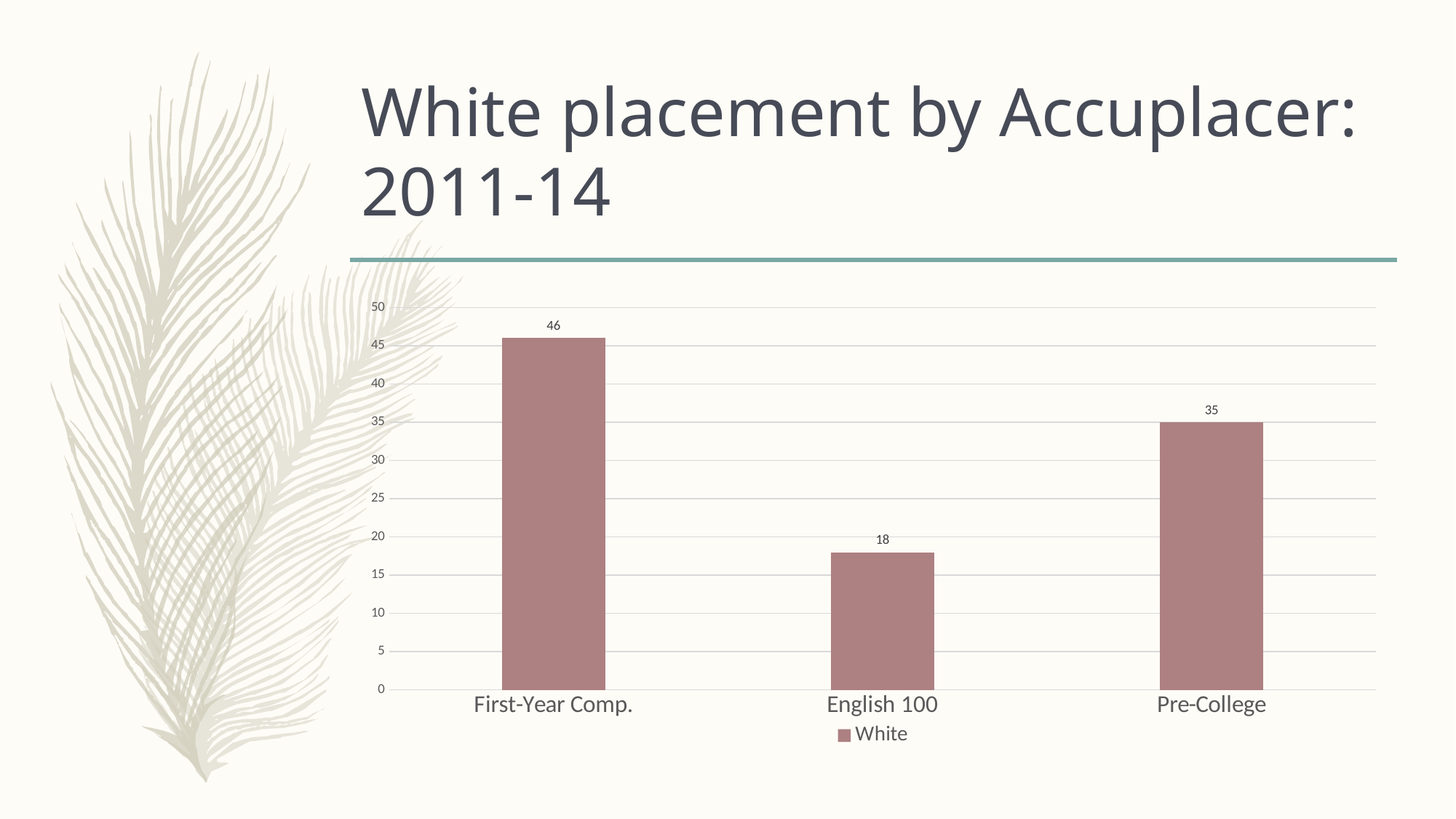
What is the difference between the values for Pre-College and English 100? 17 What is the value for Pre-College? 35 Which category has the highest value? First-Year Comp. What kind of chart is shown on the slide? bar chart What is the value for First-Year Comp.? 46 Is the value for English 100 greater or less than 20? less Which category has the lowest value? English 100 What is the value for English 100? 18 Which is larger, the value for English 100 or the value for Pre-College? Pre-College What is the difference between the values for First-Year Comp. and Pre-College? 11 How many categories are shown on the x axis? 3 How many series does the legend list? 1